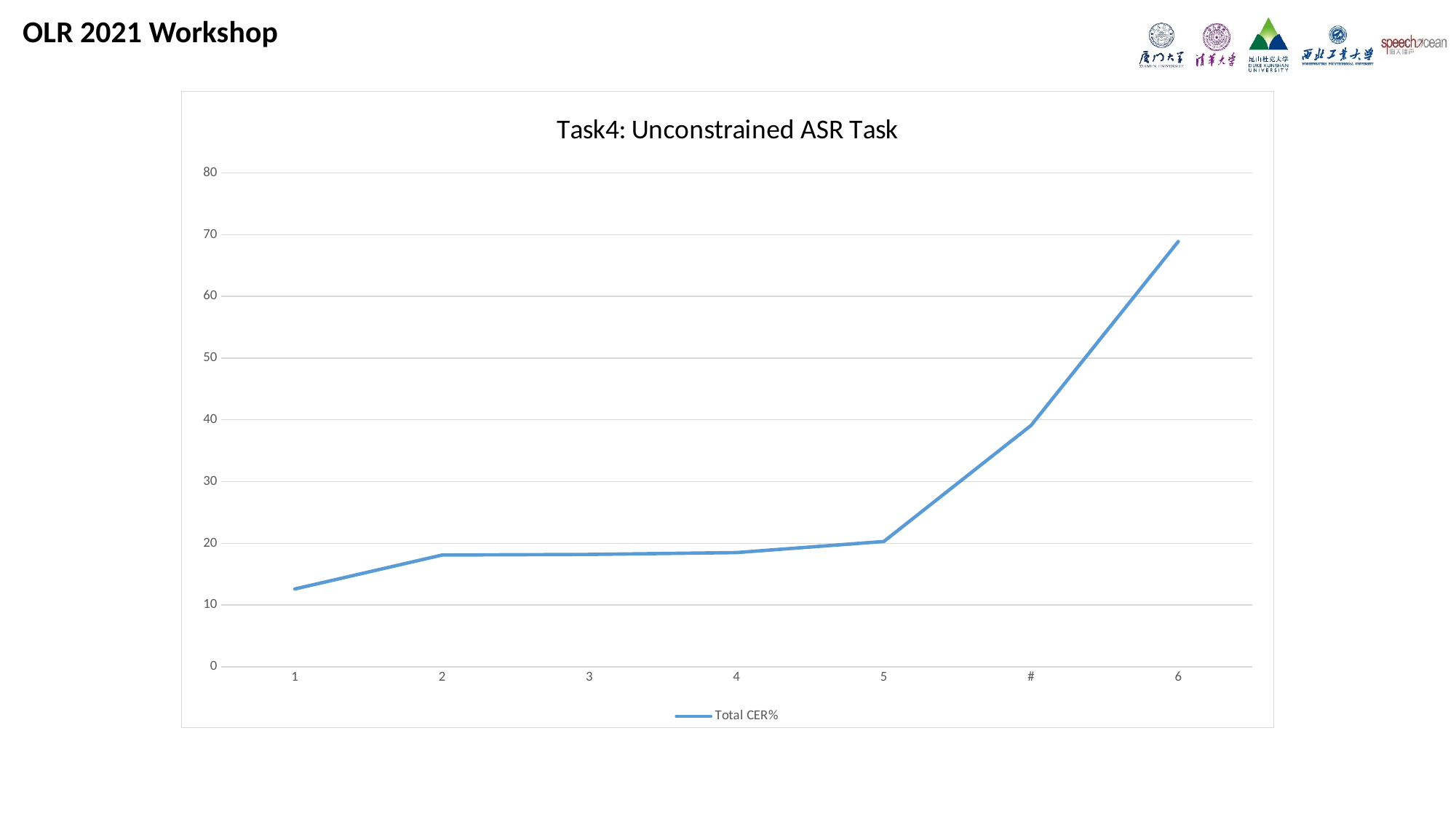
Which x-axis category has the lowest Total CER%? 1 What is the title of the chart? Task4: Unconstrained ASR Task Is the Total CER% value for category 6 greater or less than 60? greater How many series does the legend list? 1 What kind of chart is shown on the slide? line chart Which has a larger Total CER%, category 5 or category #? # What series does the legend list? Total CER% Do the Total CER% values rise or fall from left to right along the x axis? rise Which x-axis category has the highest Total CER%? 6 Is the Total CER% value for category 1 greater or less than 20? less How many points are plotted along the x axis? 7 Is the Total CER% value for category # greater or less than 30? greater